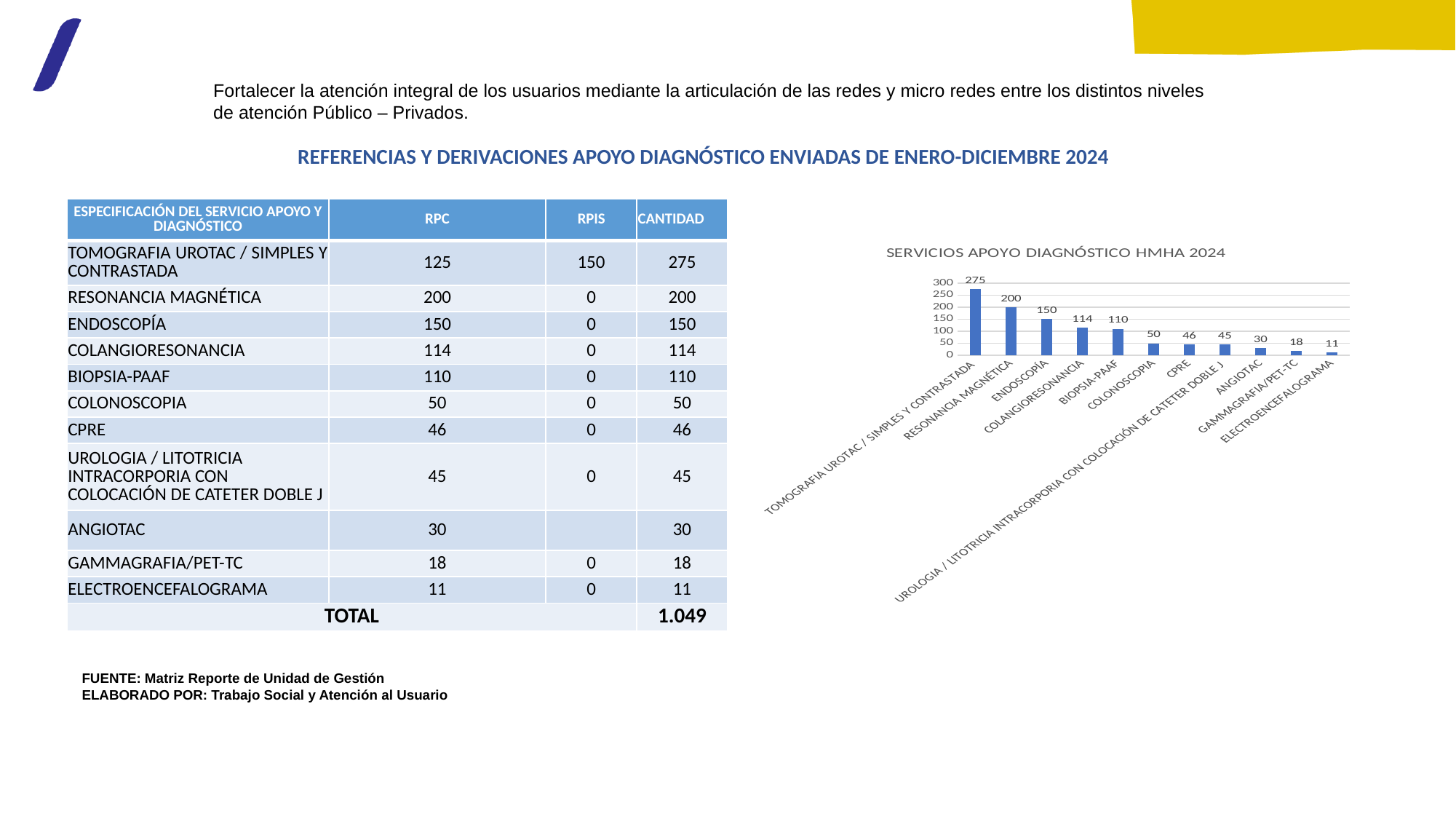
What is the difference between the values for ENDOSCOPÍA and BIOPSIA-PAAF in the chart? 40 What is the value for RESONANCIA MAGNÉTICA in the chart? 200 What is the value for COLANGIORESONANCIA in the chart? 114 What type of chart is shown on the slide? bar chart Is the value for GAMMAGRAFIA/PET-TC in the chart greater or less than 50? less What is the value for ELECTROENCEFALOGRAMA in the chart? 11 Which is larger in the chart, the value for COLONOSCOPIA or the value for ANGIOTAC? COLONOSCOPIA What is the title of the chart on the slide? SERVICIOS APOYO DIAGNÓSTICO HMHA 2024 Which category has the lowest value in the chart? ELECTROENCEFALOGRAMA Do the values in the chart rise or fall from left to right along the x axis? fall How many categories are plotted in the chart? 11 Which category has the highest value in the chart? TOMOGRAFIA UROTAC / SIMPLES Y CONTRASTADA